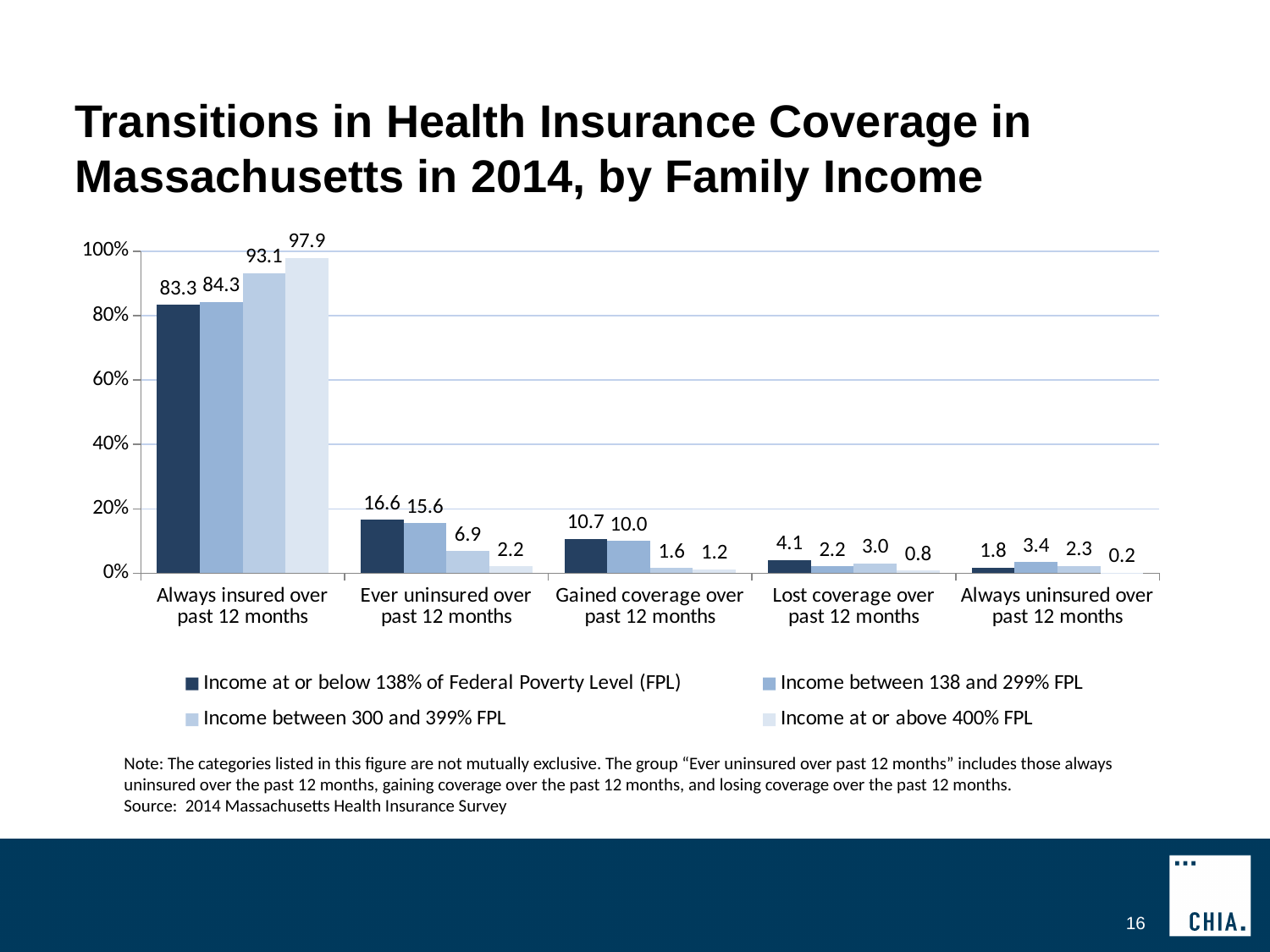
What kind of chart is shown on the slide? Bar chart Which income group has the highest value in the 'Always insured over past 12 months' category? Income at or above 400% FPL What is the value for 'Income between 300 and 399% FPL' in the 'Lost coverage over past 12 months' category? 3.0 What is the value for 'Income between 138 and 299% FPL' in the 'Gained coverage over past 12 months' category? 10.0 What is the difference between the 'Income at or above 400% FPL' and 'Income at or below 138% of Federal Poverty Level (FPL)' values in the 'Always insured over past 12 months' category? 14.6 How many series does the legend list? 4 What is the value for 'Income at or above 400% FPL' in the 'Always insured over past 12 months' category? 97.9 How many categories are shown on the x axis? 5 Is the value for 'Income between 300 and 399% FPL' in the 'Always insured over past 12 months' category greater or less than 80%? greater Which income group has the lowest value in the 'Always uninsured over past 12 months' category? Income at or above 400% FPL In the 'Ever uninsured over past 12 months' category, which is larger: the value for 'Income between 138 and 299% FPL' or 'Income between 300 and 399% FPL'? Income between 138 and 299% FPL What is the value for 'Income at or below 138% of Federal Poverty Level (FPL)' in the 'Ever uninsured over past 12 months' category? 16.6